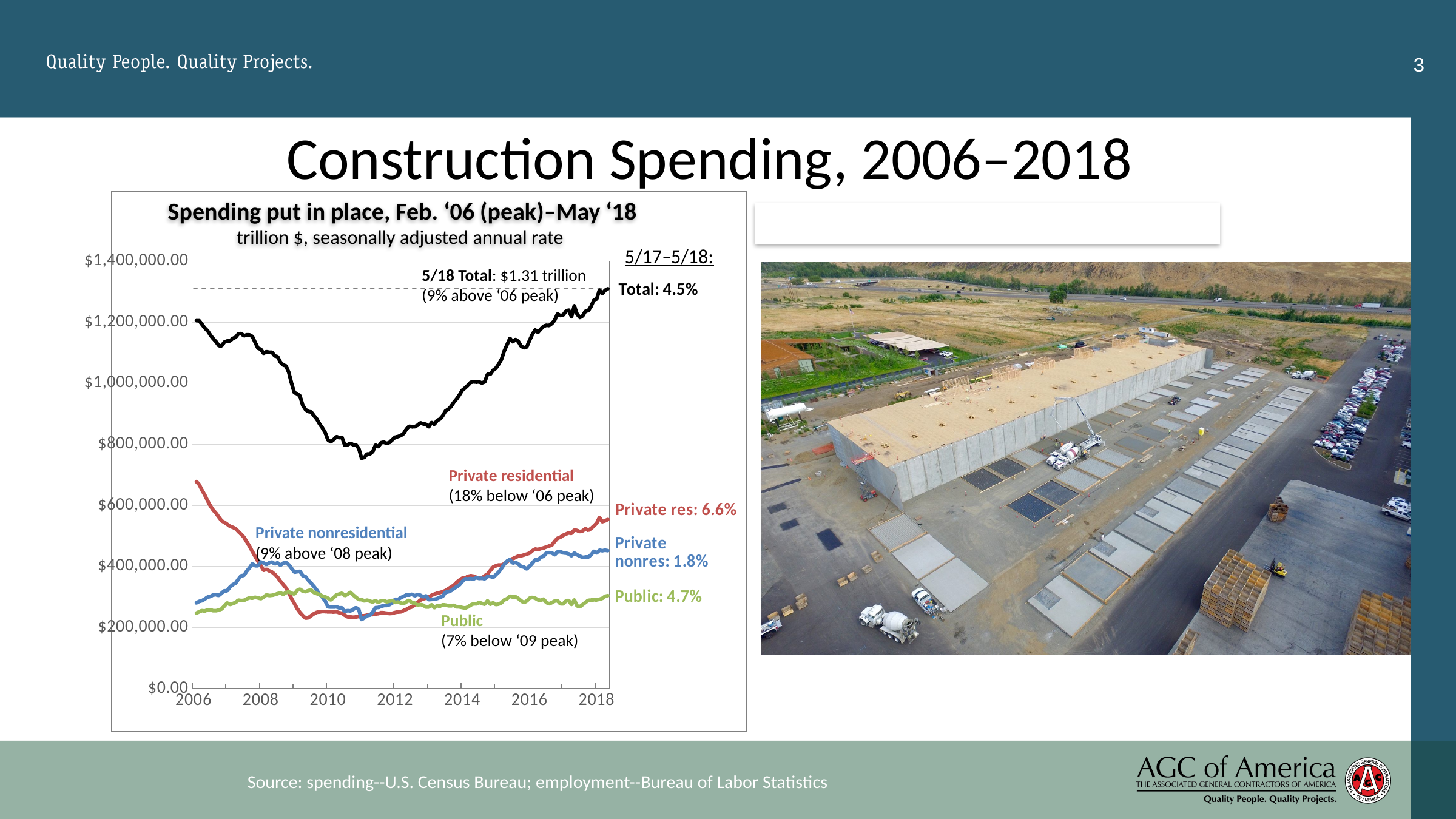
What was total construction spending in 5/18 according to the chart annotation? $1.31 trillion What kind of chart is shown on the slide? Line chart Which category had the largest 5/17–5/18 percentage change? Private residential What was the 5/17–5/18 change in total spending? 4.5% What was the 5/17–5/18 change in public spending? 4.7% What was the 5/17–5/18 change in private residential spending? 6.6% What was the 5/17–5/18 change in private nonresidential spending? 1.8% What is the title of the chart? Spending put in place, Feb. '06 (peak)–May '18 How many spending series are plotted on the chart? 4 Which category had the smallest 5/17–5/18 percentage change? Private nonresidential How many percentage points higher was the 5/17–5/18 change for private residential than for private nonresidential? 4.8 percentage points